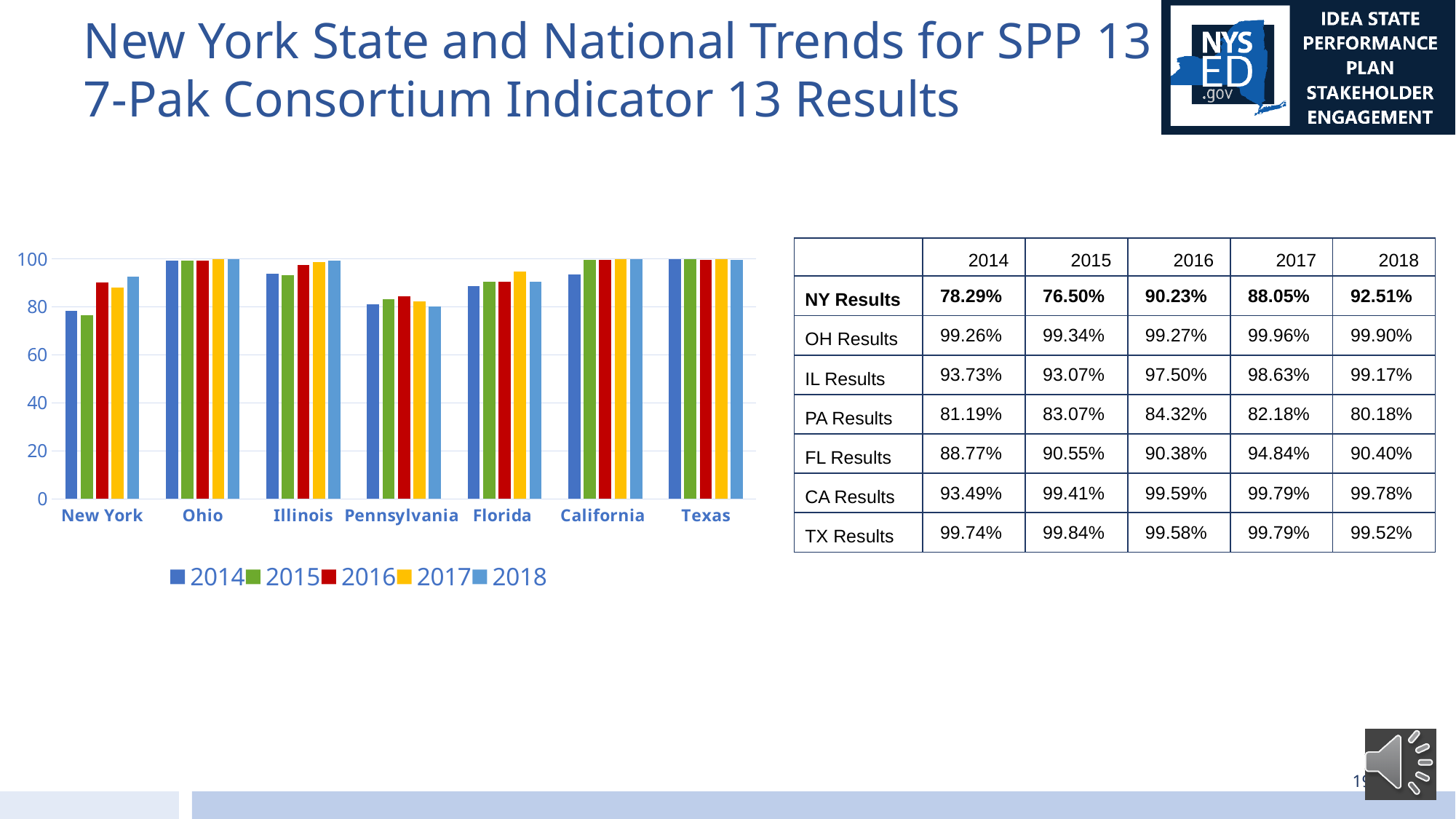
Which is larger, the Florida result for 2017 or the Pennsylvania result for 2017? Florida What kind of chart is shown on the slide? bar chart Is the value for New York in 2015 greater or less than 80? less Which year is shown in red in the bar chart legend? 2016 Do the Illinois results rise or fall from 2015 to 2018? rise Which state has the lowest result in 2015? New York What is the New York result for 2018? 92.51% How many states are shown on the x axis of the bar chart? 7 Which state has the lowest result in 2018? Pennsylvania What is the Pennsylvania result for 2016? 84.32% How many series does the legend of the bar chart list? 5 What is the difference between the New York results for 2018 and 2014? 14.22%